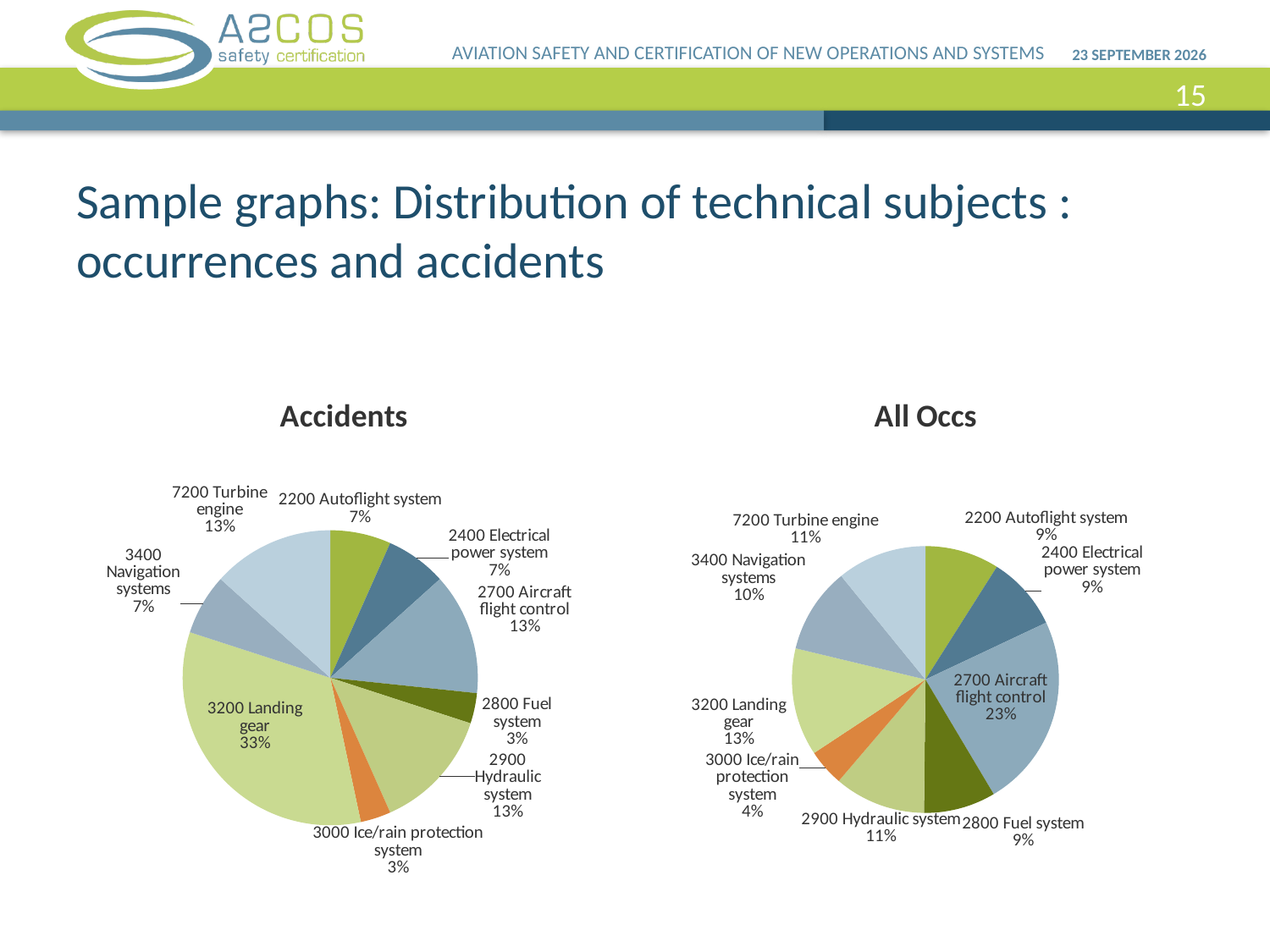
In the Accidents chart, what share does 3200 Landing gear have? 33% What is the title of the chart on the left side of the slide? Accidents In the Accidents chart, which category has the largest slice? 3200 Landing gear What type of chart is the All Occs chart? Pie chart In the All Occs chart, which category has the smallest slice? 3000 Ice/rain protection system In the All Occs chart, what is the share for 3400 Navigation systems? 10% How many categories are shown in the Accidents chart? 9 In the All Occs chart, which is larger: the share for 3200 Landing gear or the share for 2900 Hydraulic system? 3200 Landing gear In the Accidents chart, what is the share for 2900 Hydraulic system? 13% In the All Occs chart, which category has the largest slice? 2700 Aircraft flight control In the All Occs chart, what share does 2700 Aircraft flight control have? 23% In the Accidents chart, what is the difference between the shares of 3200 Landing gear and 7200 Turbine engine? 20%